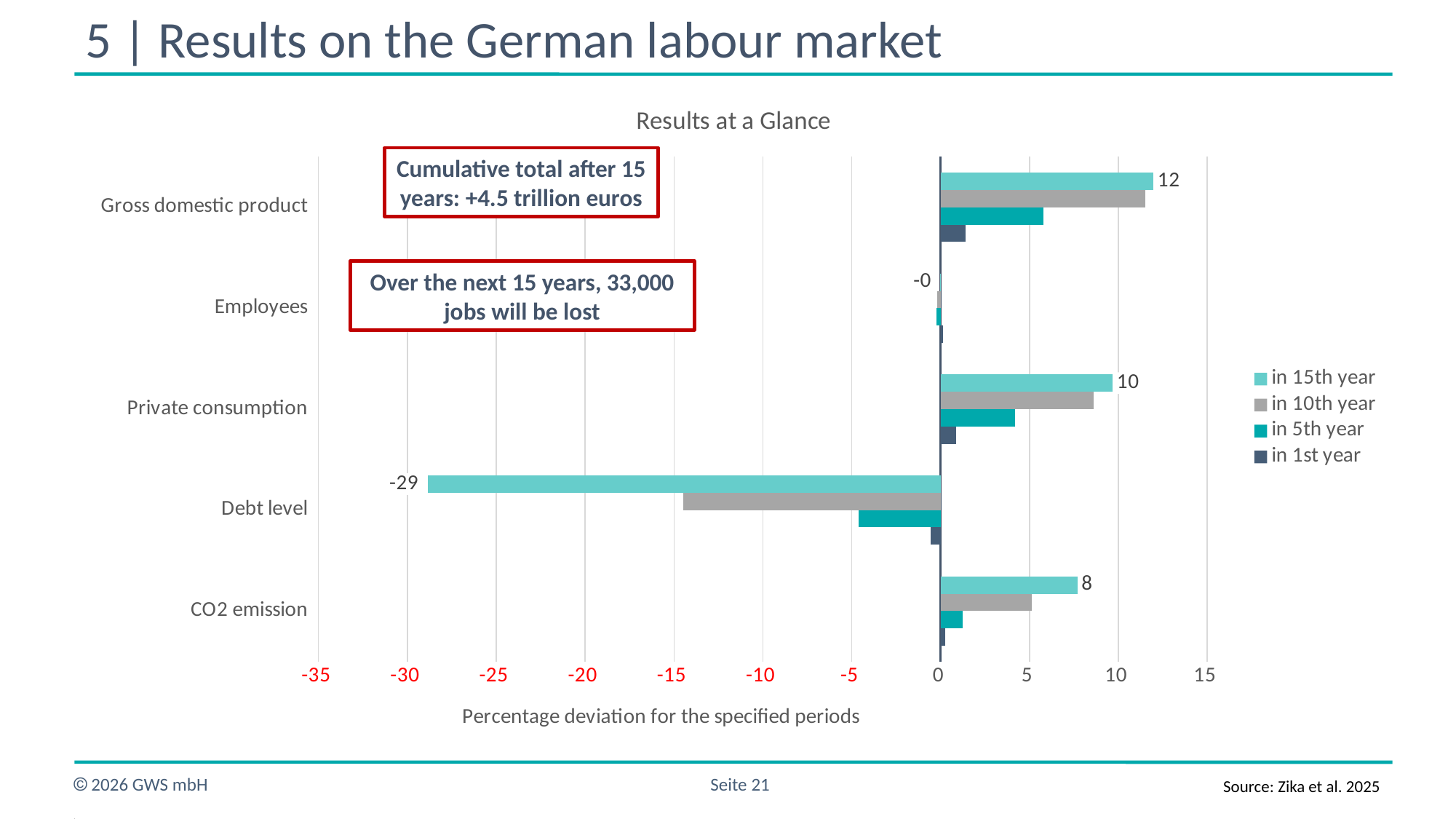
What kind of chart is shown on the slide? Bar chart Is the value for Debt level in the 10th year greater or less than -10? less Which category has the lowest value in the 15th year? Debt level How many categories are shown on the y axis of the chart? 5 What is the difference between the 15th-year values for Gross domestic product and Private consumption? 2 Which category has the highest value in the 15th year? Gross domestic product Which is larger in the 15th year: Gross domestic product or CO2 emission? Gross domestic product What is the value for Gross domestic product in the 15th year? 12 What is the value for CO2 emission in the 15th year? 8 What is the value for Private consumption in the 15th year? 10 What is the value for Debt level in the 15th year? -29 How many series does the legend list? 4